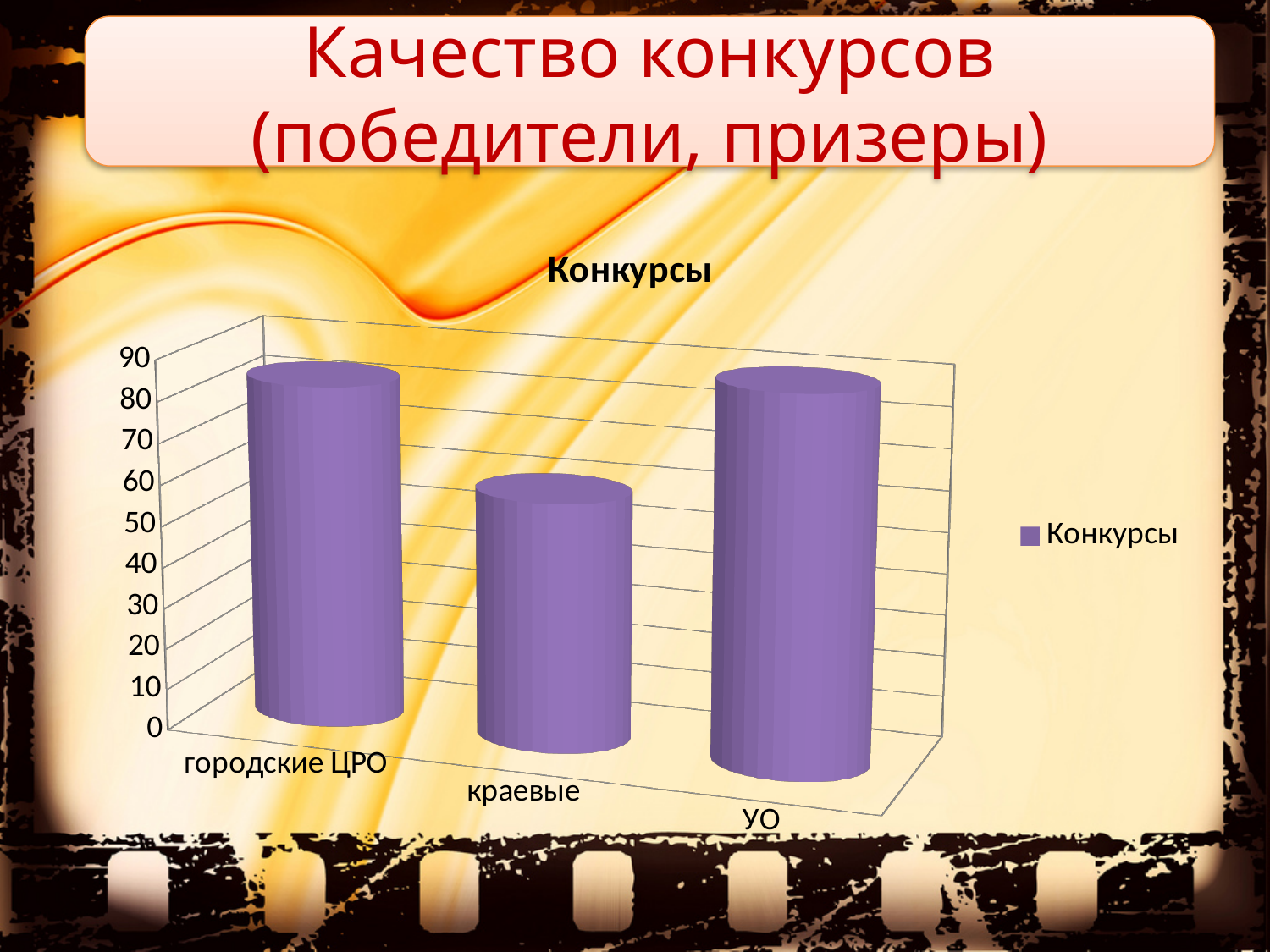
How many categories are plotted on the x axis of the chart? 3 What is the name of the series shown in the chart's legend? Конкурсы Is the value for краевые greater or less than 70? less How many series does the chart's legend list? 1 What kind of chart is shown on the slide? bar chart Which category has the lowest value in the chart? краевые Is the value for городские ЦРО greater or less than 50? greater What is the title of the chart? Конкурсы Is the value for УО greater or less than 50? greater Which is larger, the value for городские ЦРО or the value for краевые? городские ЦРО Which is larger, the value for УО or the value for краевые? УО